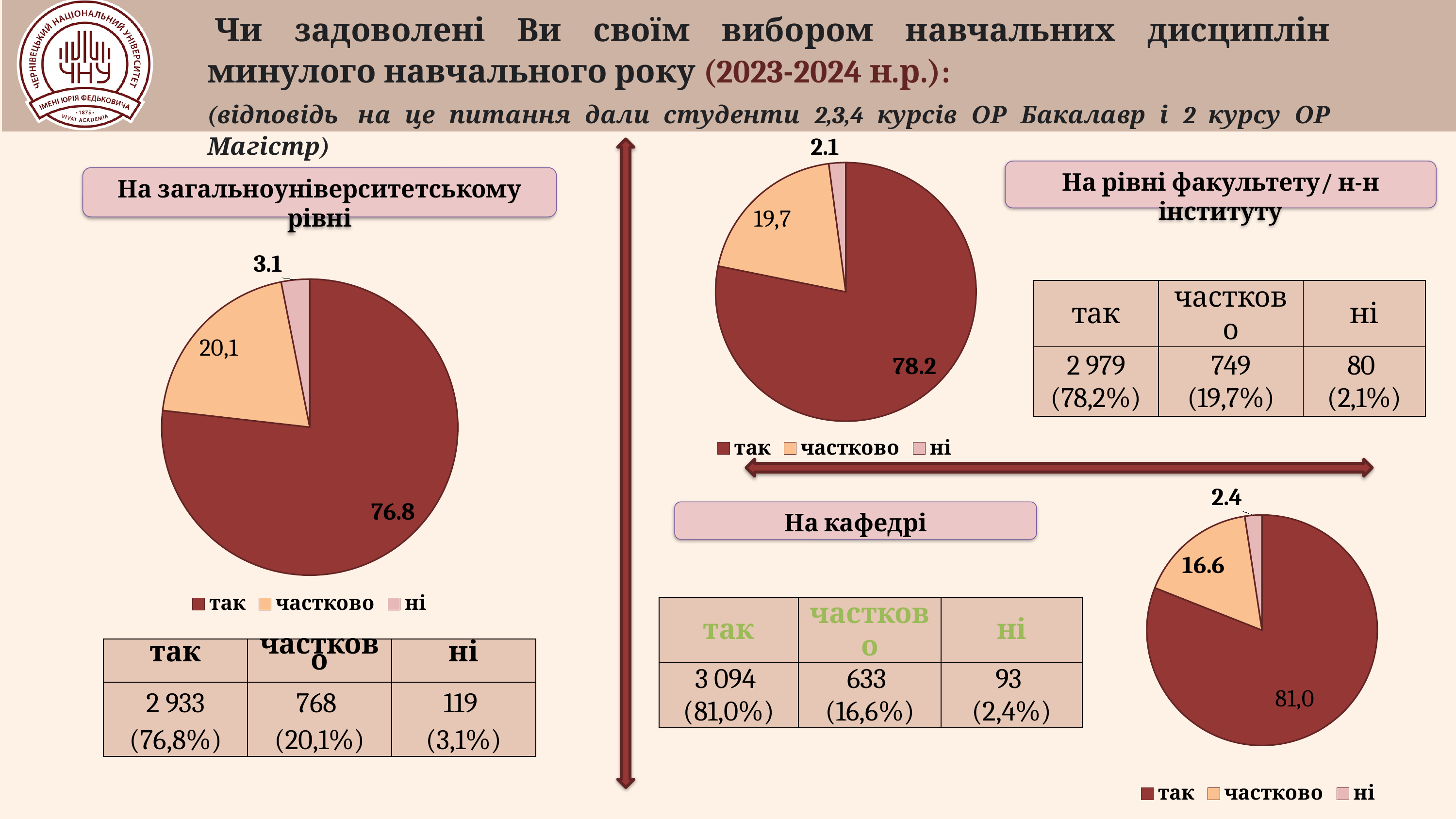
What kind of chart is used for 'На кафедрі'? pie chart How many entries does the legend of the 'На рівні факультету/ н-н інституту' chart list? 3 On the pie chart 'На кафедрі', what value is shown for the 'частково' slice? 16.6 On the pie chart 'На кафедрі', which slice is the largest? так On the pie chart 'На загальноуніверситетському рівні', what value is shown for the 'ні' slice? 3.1 On the pie chart 'На загальноуніверситетському рівні', what value is shown for the 'так' slice? 76.8 On the pie chart 'На рівні факультету/ н-н інституту', which slice is the smallest? ні On the pie chart 'На загальноуніверситетському рівні', how many slices does the pie have? 3 On the pie chart 'На рівні факультету/ н-н інституту', what value is shown for the 'частково' slice? 19,7 On the pie chart 'На кафедрі', what value is shown for the 'так' slice? 81,0 On the pie chart 'На загальноуніверситетському рівні', what value is shown for the 'частково' slice? 20,1 On the pie chart 'На рівні факультету/ н-н інституту', what value is shown for the 'ні' slice? 2.1